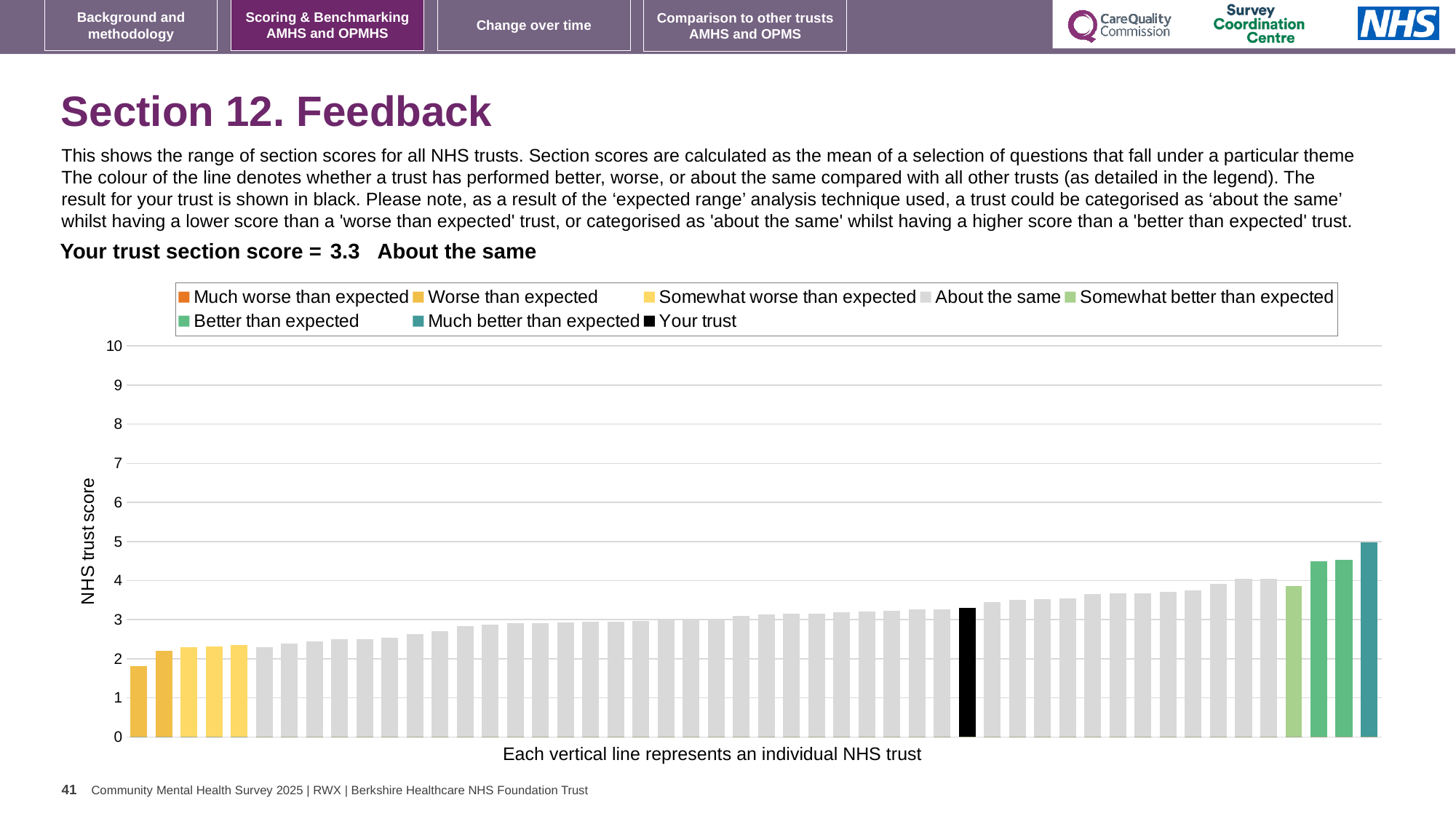
Is the value for your trust greater or less than 3? greater Which legend category does the tallest bar belong to? Much better than expected Which benchmarking category is your trust placed in for Section 12. Feedback? About the same What colour is the bar representing your trust? black What kind of chart is shown on the slide? bar chart What is the section score for your trust shown on the slide? 3.3 How many entries does the chart legend list? 8 Do the bar values rise or fall from left to right along the x axis? rise Is the value of the tallest bar greater or less than 4? greater What is the label on the vertical axis? NHS trust score Is the value of the shortest bar greater or less than 2? less